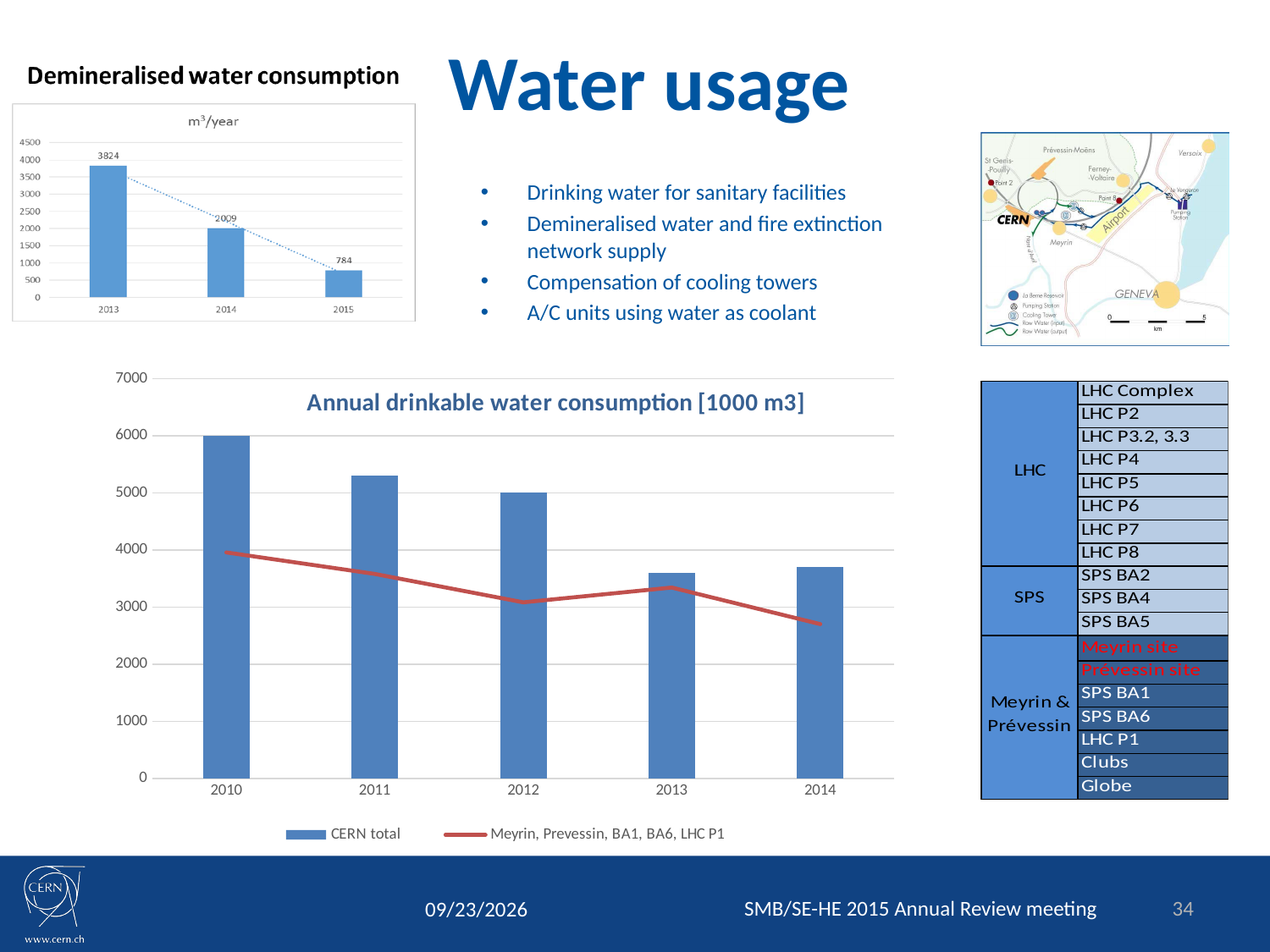
In the Demineralised water consumption chart, what was the value for 2015? 784 In the Annual drinkable water consumption chart, how many series does the legend list? 2 In the Annual drinkable water consumption chart, which year has the highest CERN total bar? 2010 In the Demineralised water consumption chart, how many years are shown? 3 In the Annual drinkable water consumption chart, which series is drawn as a red line? Meyrin, Prevessin, BA1, BA6, LHC P1 In the Demineralised water consumption chart, which year has the lowest value? 2015 In the Demineralised water consumption chart, what was the value for 2013? 3824 In the Annual drinkable water consumption chart, is the Meyrin, Prevessin, BA1, BA6, LHC P1 value for 2014 greater or less than 3000? less In the Annual drinkable water consumption chart, is the CERN total for 2011 greater or less than 5000? greater In the Demineralised water consumption chart, what is the difference between the 2013 and 2014 values? 1815 In the Annual drinkable water consumption chart, is the CERN total for 2013 greater or less than 4000? less In the Demineralised water consumption chart, do the values rise or fall from 2013 to 2015? fall